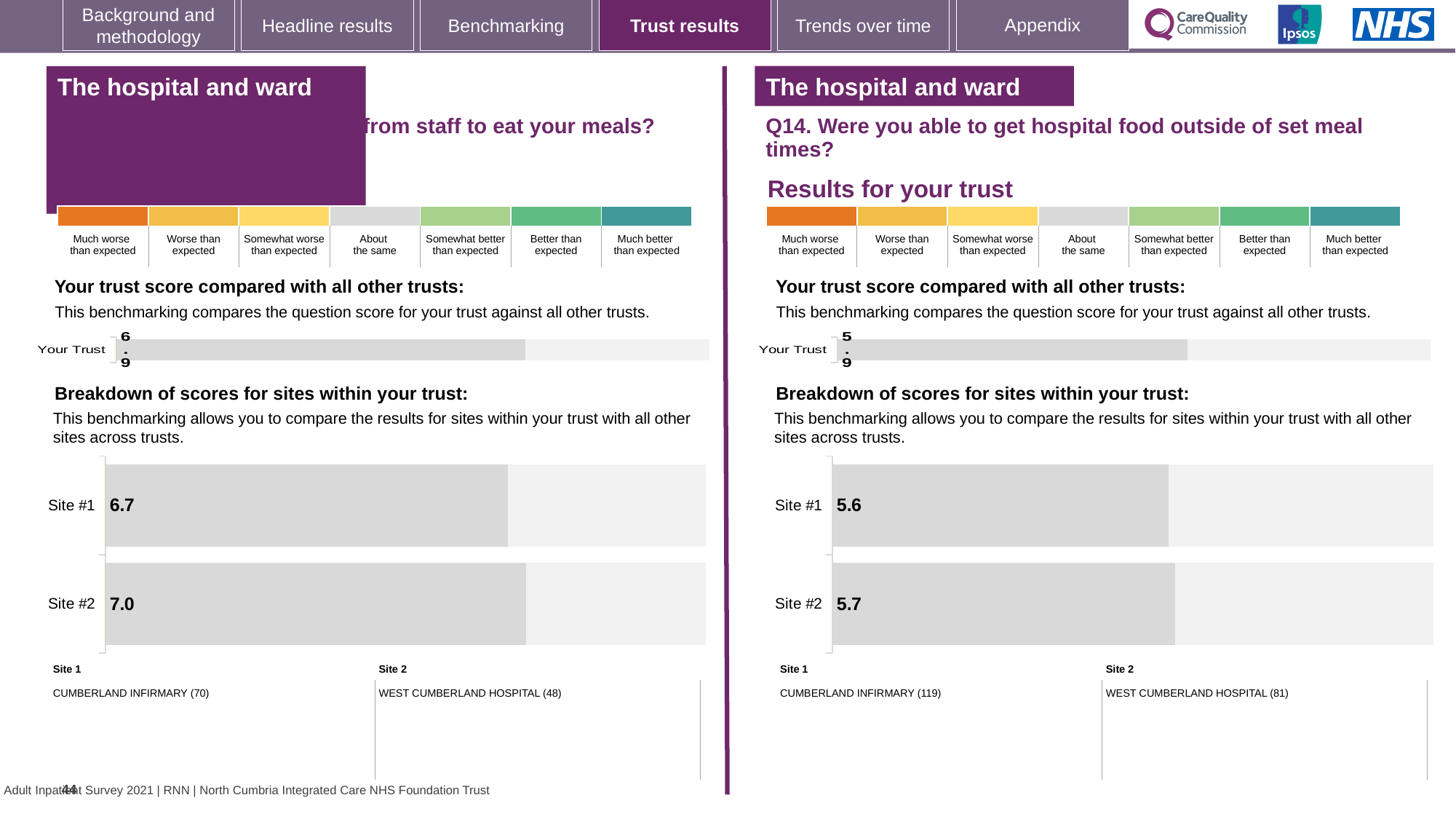
In the right-hand breakdown of scores for sites chart (Q14), what is the score for Site #2? 5.7 In the left-hand breakdown of scores for sites chart, what is the difference between the Site #2 and Site #1 scores? 0.3 In the right-hand breakdown of scores for sites chart (Q14), which site has the lower score? Site #1 In the left-hand breakdown of scores for sites chart, which site has the higher score? Site #2 In the left-hand breakdown of scores for sites chart, what is the score for Site #2? 7.0 In the right-hand breakdown of scores for sites chart (Q14), what is the difference between the Site #2 and Site #1 scores? 0.1 In the right-hand breakdown of scores for sites chart (Q14), what is the score for Site #1? 5.6 In the left-hand breakdown of scores for sites chart, what is the score for Site #1? 6.7 On the right-hand side of the slide (Q14), what is the score shown for Your Trust? 5.9 How many sites are shown in the right-hand breakdown of scores for sites chart (Q14)? 2 On the left-hand side of the slide, what is the score shown for Your Trust? 6.9 What type of chart is used for the breakdown of scores for sites within your trust? Bar chart